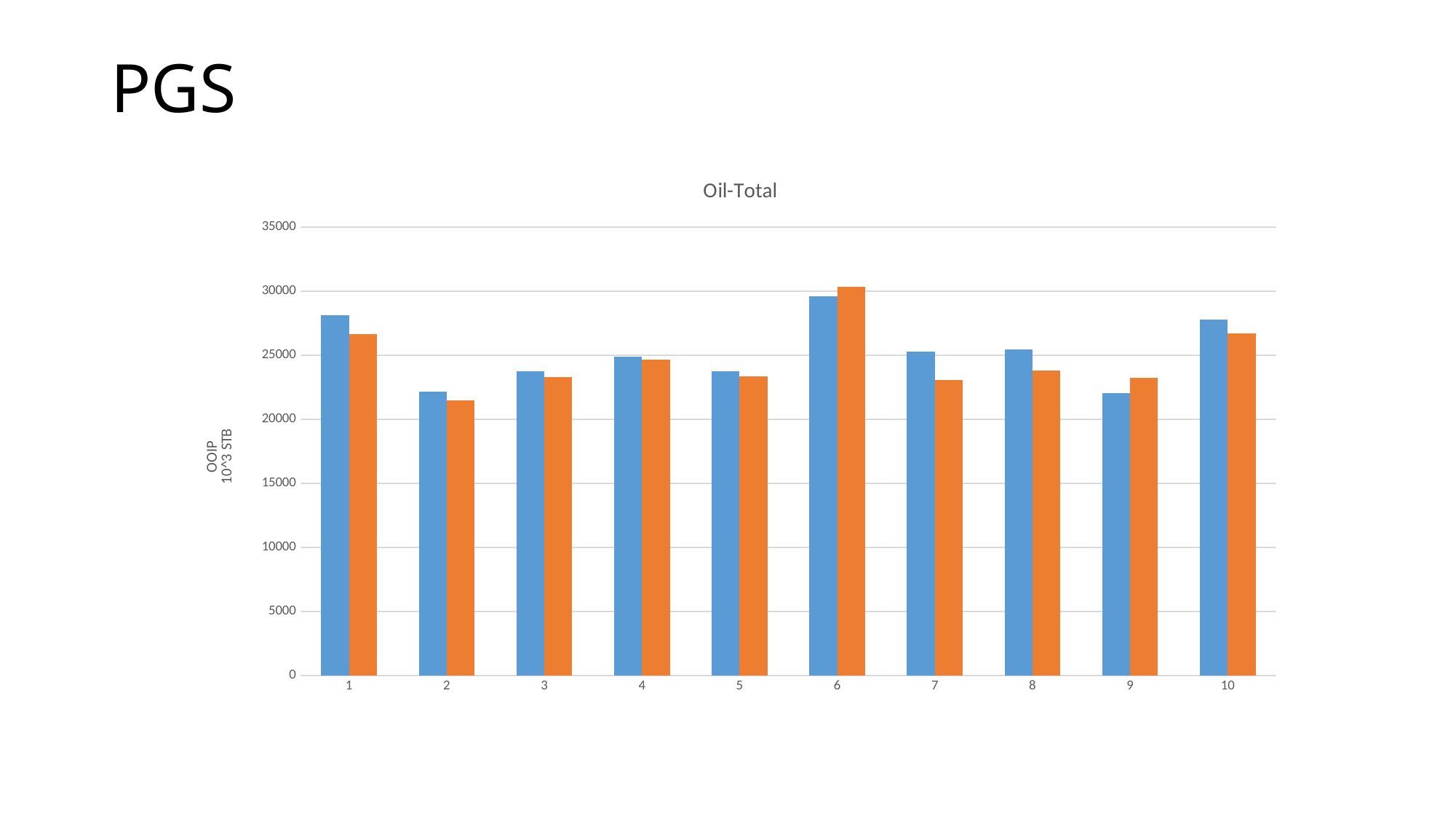
Is the blue bar for category 1 greater or less than 25000? greater Which category has the lowest orange bar in the chart? 2 Is the orange bar for category 2 greater or less than 25000? less What is the title of the chart? Oil-Total What is the label on the vertical axis of the chart? OOIP 10^3 STB Which category has the tallest bars in the chart? 6 How many categories are shown along the x axis of the chart? 10 For category 6, which bar is taller, the blue one or the orange one? orange Is the orange bar for category 7 greater or less than 25000? less What kind of chart is shown on the slide? bar chart For category 1, which bar is taller, the blue one or the orange one? blue